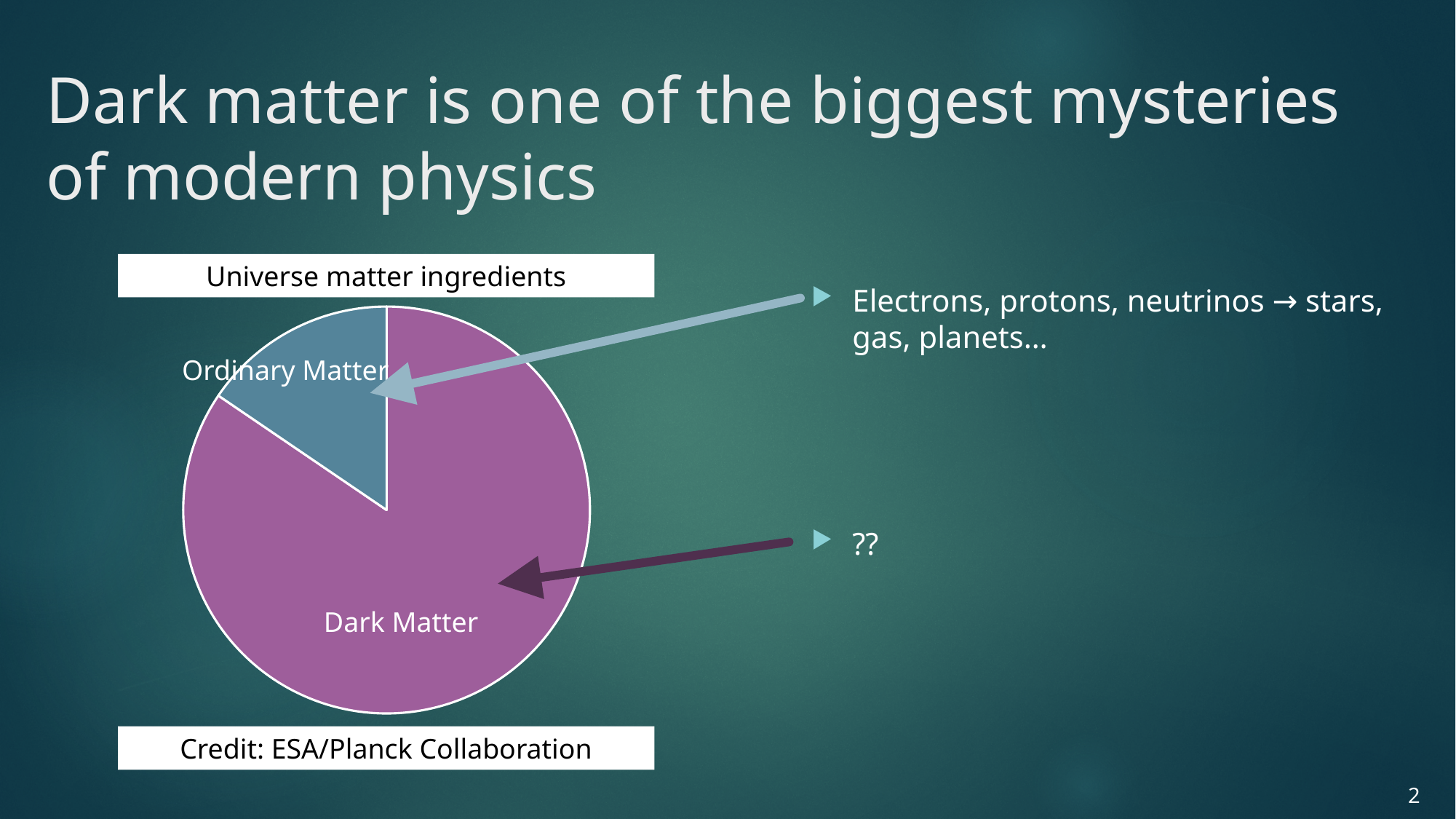
Which slice of the pie chart is the largest? Dark Matter What colour is the Dark Matter slice of the pie chart? Purple What is the title of the pie chart? Universe matter ingredients Which is larger in the pie chart, Dark Matter or Ordinary Matter? Dark Matter Which slice of the pie chart is the smallest? Ordinary Matter What kind of chart is shown on the slide? Pie chart How many slices does the pie chart have? 2